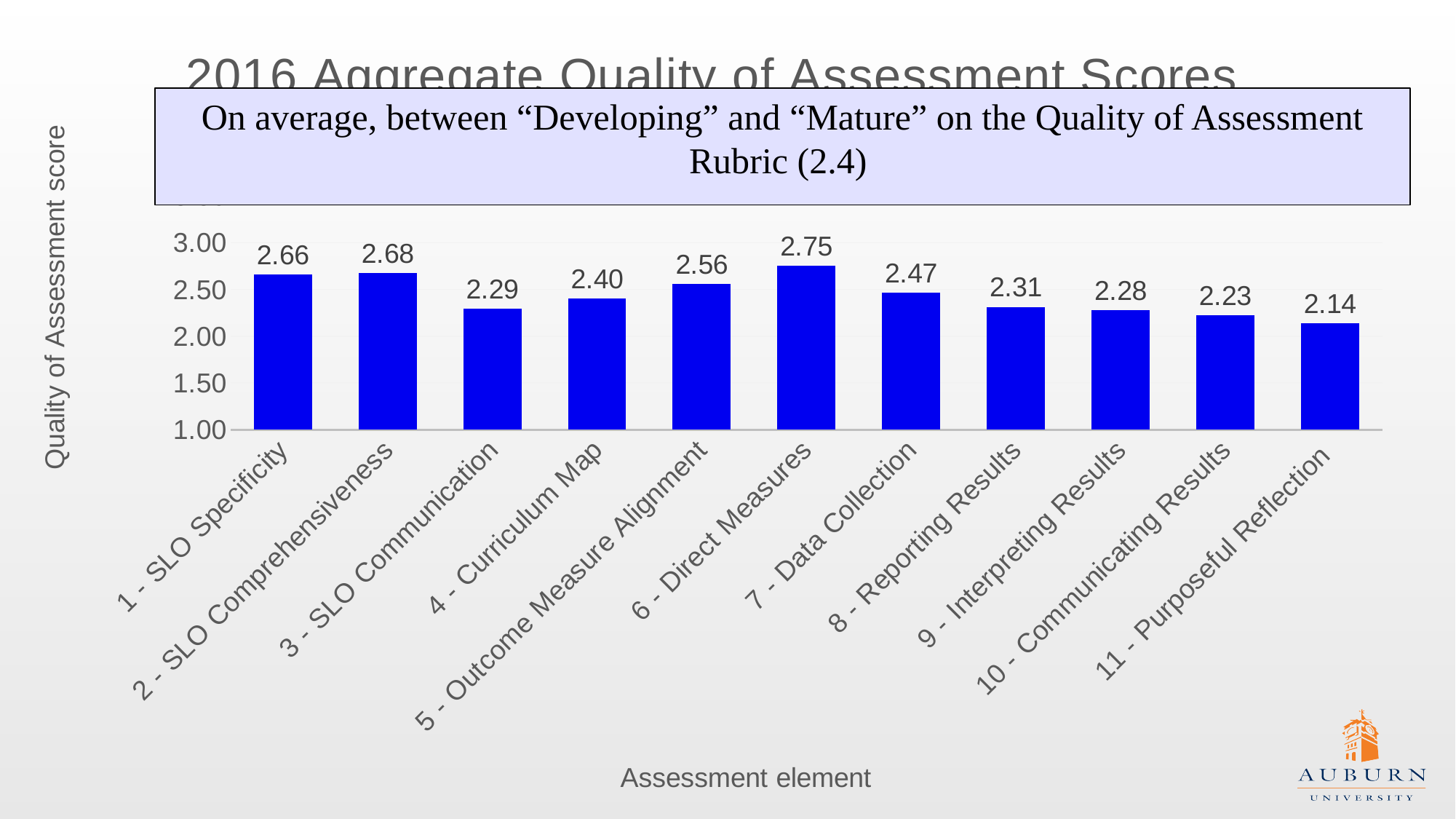
Is the value for 8 - Reporting Results greater or less than 2.50? less Which assessment element has the lowest Quality of Assessment score? 11 - Purposeful Reflection What is the difference between the scores for 1 - SLO Specificity and 4 - Curriculum Map? 0.26 Which assessment element has the highest Quality of Assessment score? 6 - Direct Measures What is the Quality of Assessment score for 6 - Direct Measures? 2.75 What is the label of the x axis of the chart? Assessment element How many assessment elements are shown in the chart? 11 What is the Quality of Assessment score for 3 - SLO Communication? 2.29 What is the Quality of Assessment score for 11 - Purposeful Reflection? 2.14 Which has a higher score, 5 - Outcome Measure Alignment or 7 - Data Collection? 5 - Outcome Measure Alignment What kind of chart is shown on the slide? bar chart What is the difference between the scores for 6 - Direct Measures and 11 - Purposeful Reflection? 0.61